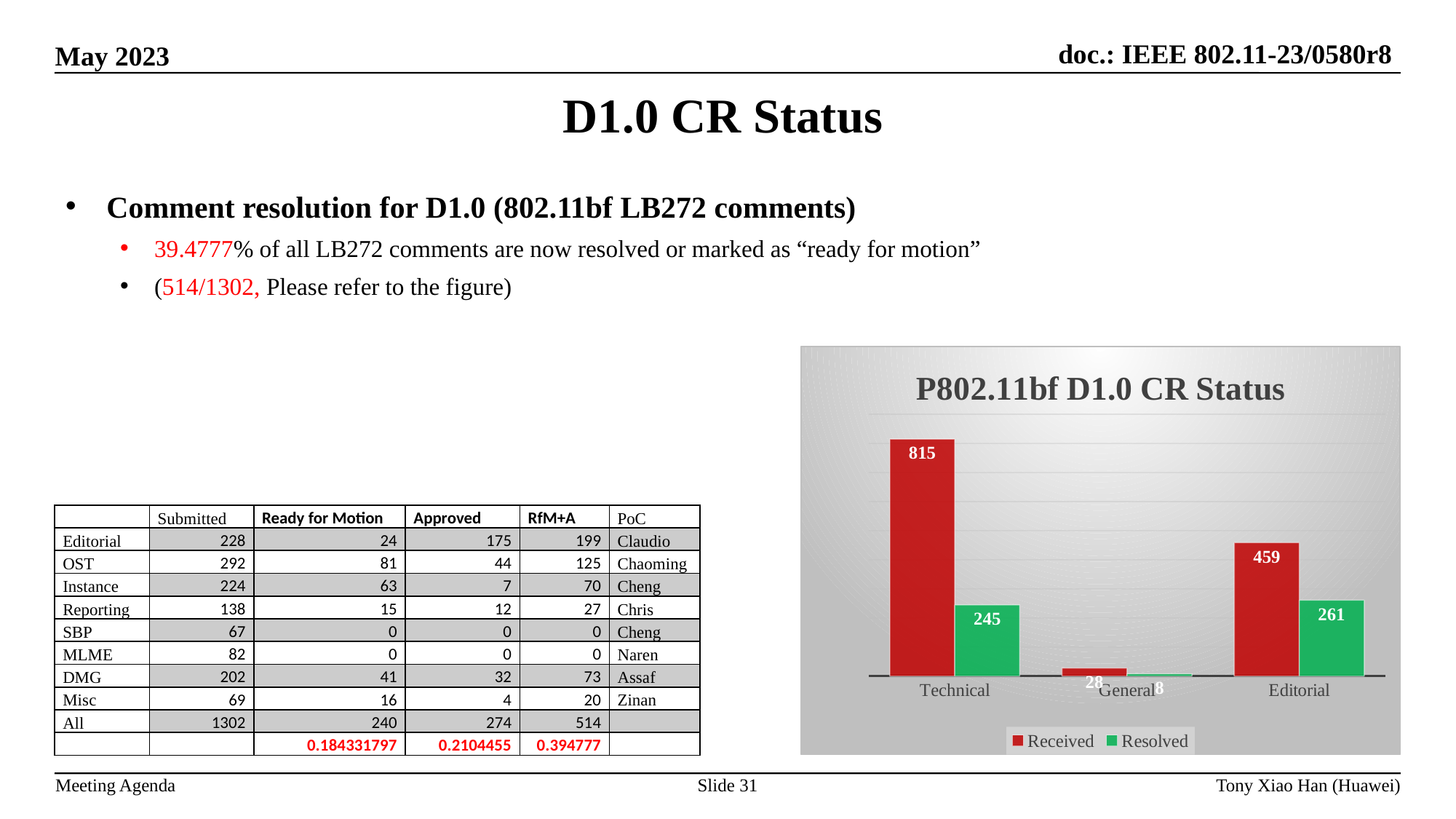
How many categories are shown on the x axis of the chart? 3 What kind of chart is shown on the slide? bar chart What is the Resolved value for Editorial in the chart? 261 What is the title of the chart on the slide? P802.11bf D1.0 CR Status What is the difference between the Received and Resolved values for Technical in the chart? 570 How many series does the chart legend list? 2 What is the Received value for Technical in the chart? 815 Which category has the lowest Resolved value in the chart? General Which category has the highest Received value in the chart? Technical What is the Received value for Editorial in the chart? 459 What is the Resolved value for Technical in the chart? 245 Is the Resolved value for Editorial larger or smaller than the Resolved value for Technical in the chart? larger